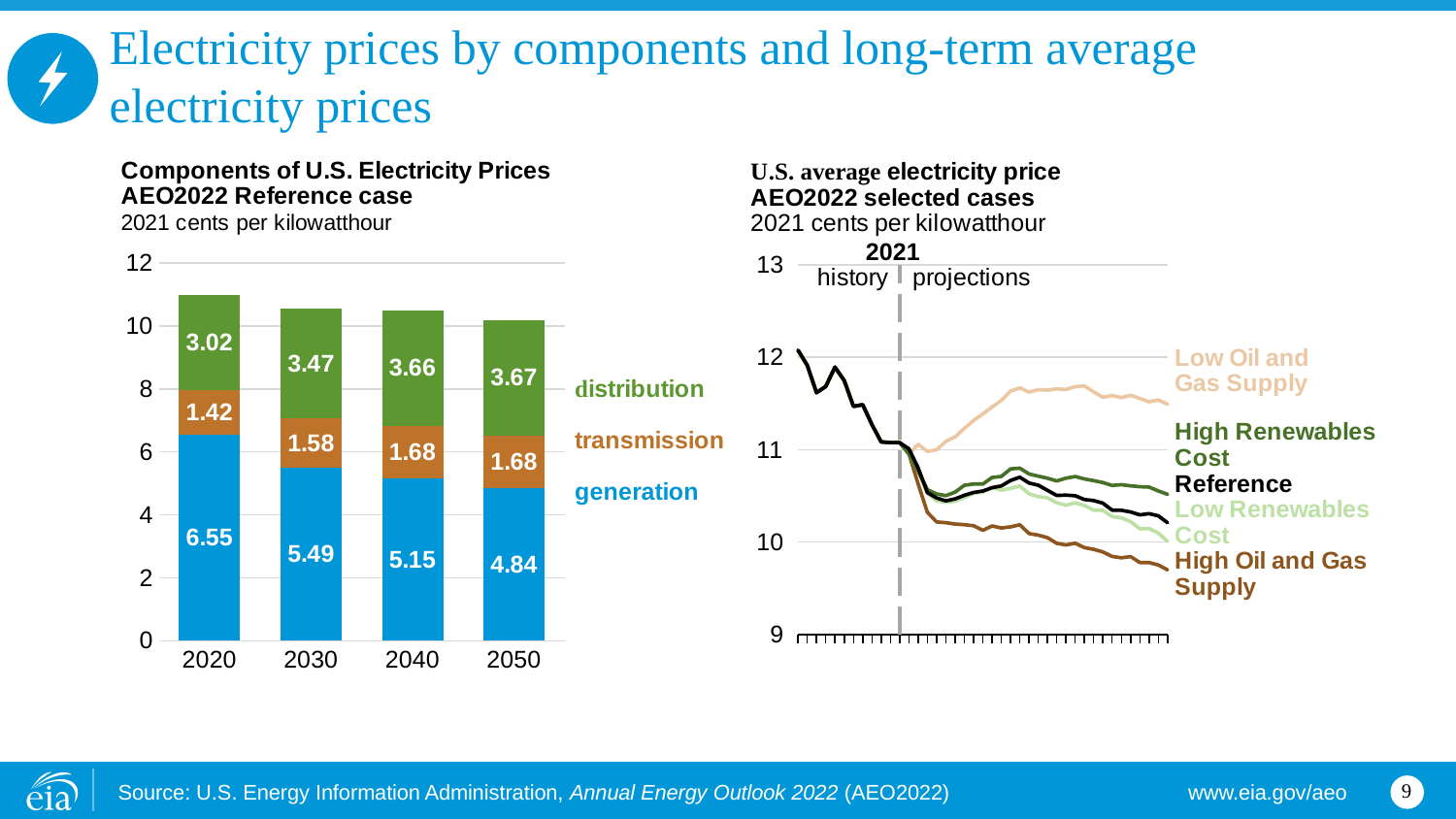
In the Components of U.S. Electricity Prices chart, what is the difference between the generation component in 2020 and in 2050? 1.71 In the Components of U.S. Electricity Prices chart, what is the transmission component in 2030? 1.58 In the Components of U.S. Electricity Prices chart, what is the total electricity price in 2030? 10.54 In the Components of U.S. Electricity Prices chart, what is the generation component in 2020? 6.55 In the Components of U.S. Electricity Prices chart, is the distribution component larger in 2040 or in 2030? 2040 In the Components of U.S. Electricity Prices chart, does the generation component rise or fall from 2020 to 2050? fall In the U.S. average electricity price chart, is the Low Oil and Gas Supply case at the end of the projection greater or less than 11? greater In the Components of U.S. Electricity Prices chart, what is the distribution component in 2050? 3.67 In the Components of U.S. Electricity Prices chart, which year has the highest generation component? 2020 In the Components of U.S. Electricity Prices chart, which year has the lowest transmission component? 2020 In the U.S. average electricity price chart, is the High Oil and Gas Supply case at the end of the projection greater or less than 10? less How many cases does the U.S. average electricity price chart plot? 5